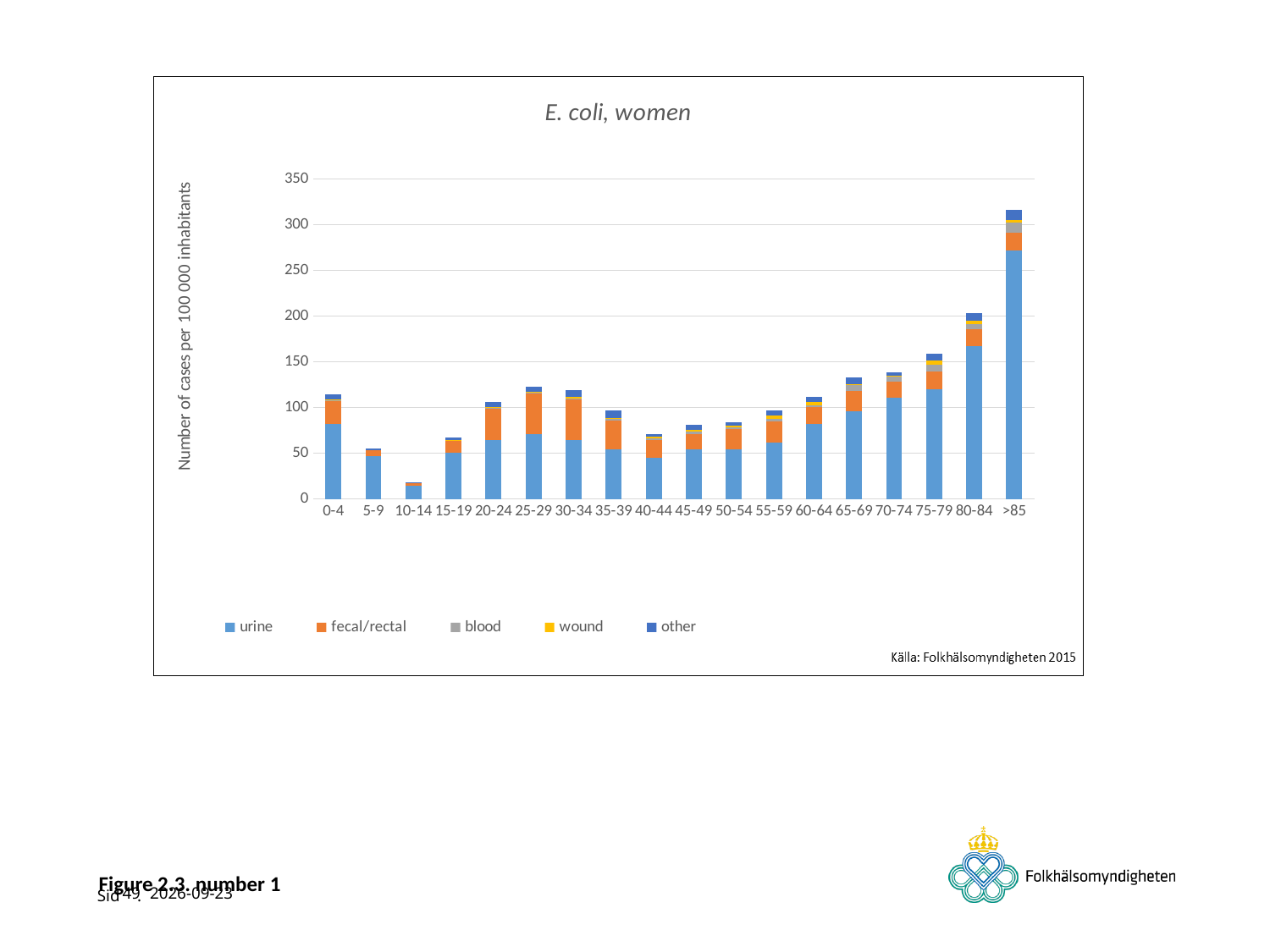
Do the total values rise or fall along the x axis from the 40-44 age group to the >85 age group? rise Which age group has a larger total, 80-84 or 75-79? 80-84 Which age group has a larger total, 0-4 or 5-9? 0-4 What kind of chart is shown on the slide? Stacked bar chart What is the title of the chart? E. coli, women Is the total value for the >85 age group greater or less than 300? greater How many series does the legend of the chart list? 5 Which age group has the lowest total number of cases per 100 000 inhabitants? 10-14 Which age group has the highest total number of cases per 100 000 inhabitants? >85 How many age groups are shown on the x axis of the chart? 18 Is the total value for the 80-84 age group greater or less than 150? greater Is the total value for the 10-14 age group greater or less than 50? less